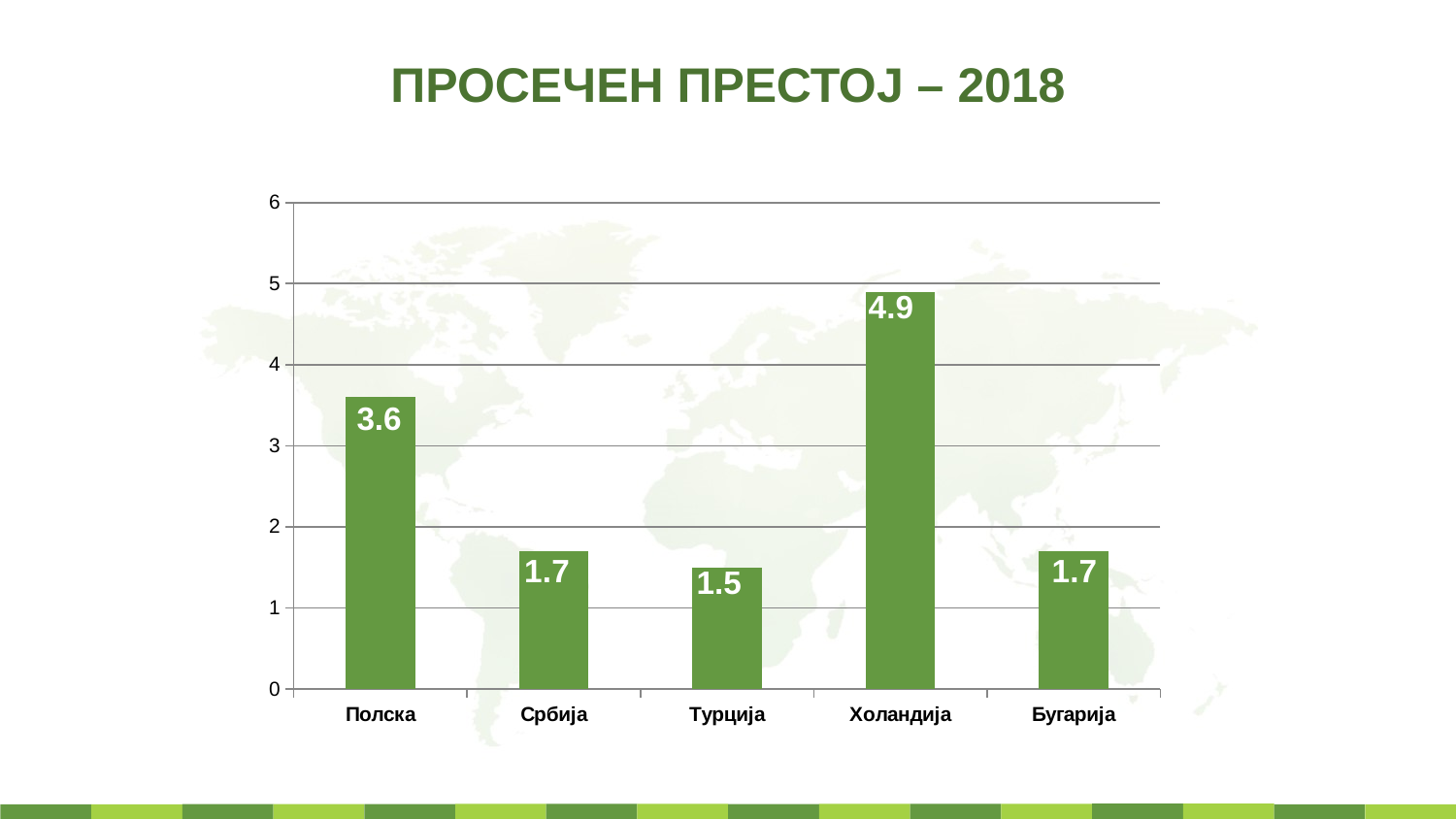
How many categories are shown on the x axis? 5 Which is larger, the value for Полска or the value for Србија? Полска What is the difference between the values for Холандија and Полска? 1.3 Which category has the highest value? Холандија Which category has the lowest value? Турција What kind of chart is shown on the slide? bar chart What is the value for Турција? 1.5 What is the value for Полска? 3.6 What is the value for Бугарија? 1.7 What is the difference between the values for Србија and Турција? 0.2 What is the value for Холандија? 4.9 Is the value for Холандија greater or less than 4? greater